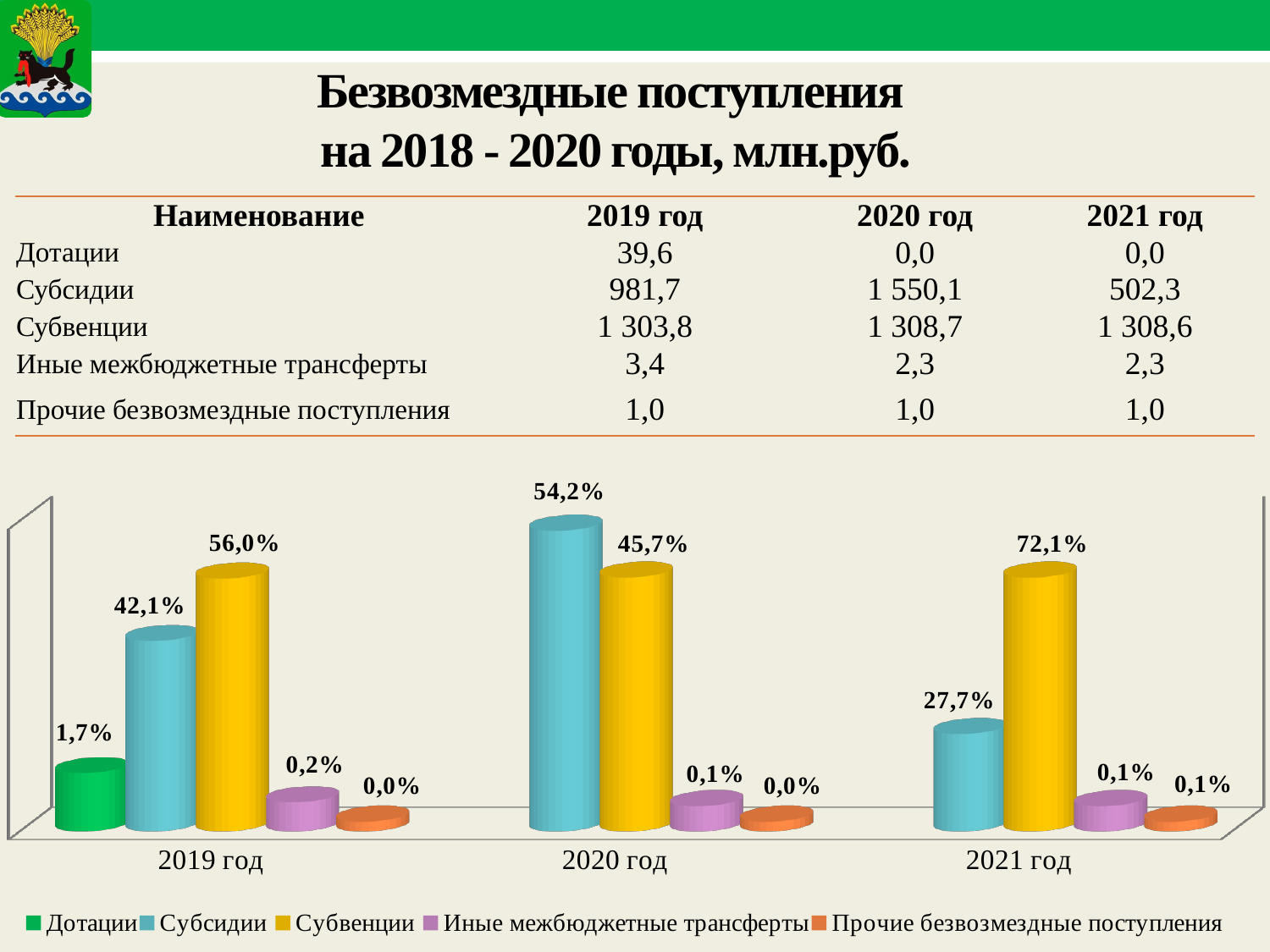
What is the value for Иные межбюджетные трансферты in 2019 год? 0,2% Which series has the highest value in 2020 год? Субсидии What kind of chart is shown on the slide? Bar chart How many series does the chart legend list? 5 Which is larger in 2019 год: Субсидии or Субвенции? Субвенции In which year is the value for Субвенции the highest? 2021 год Does the value for Субсидии rise or fall from 2020 год to 2021 год? Fall What is the value for Дотации in 2019 год? 1,7% What is the difference between Субвенции and Субсидии in 2021 год? 44,4% How many year categories are shown on the x axis of the chart? 3 What is the value for Субвенции in 2021 год? 72,1% What is the value for Субсидии in 2020 год? 54,2%